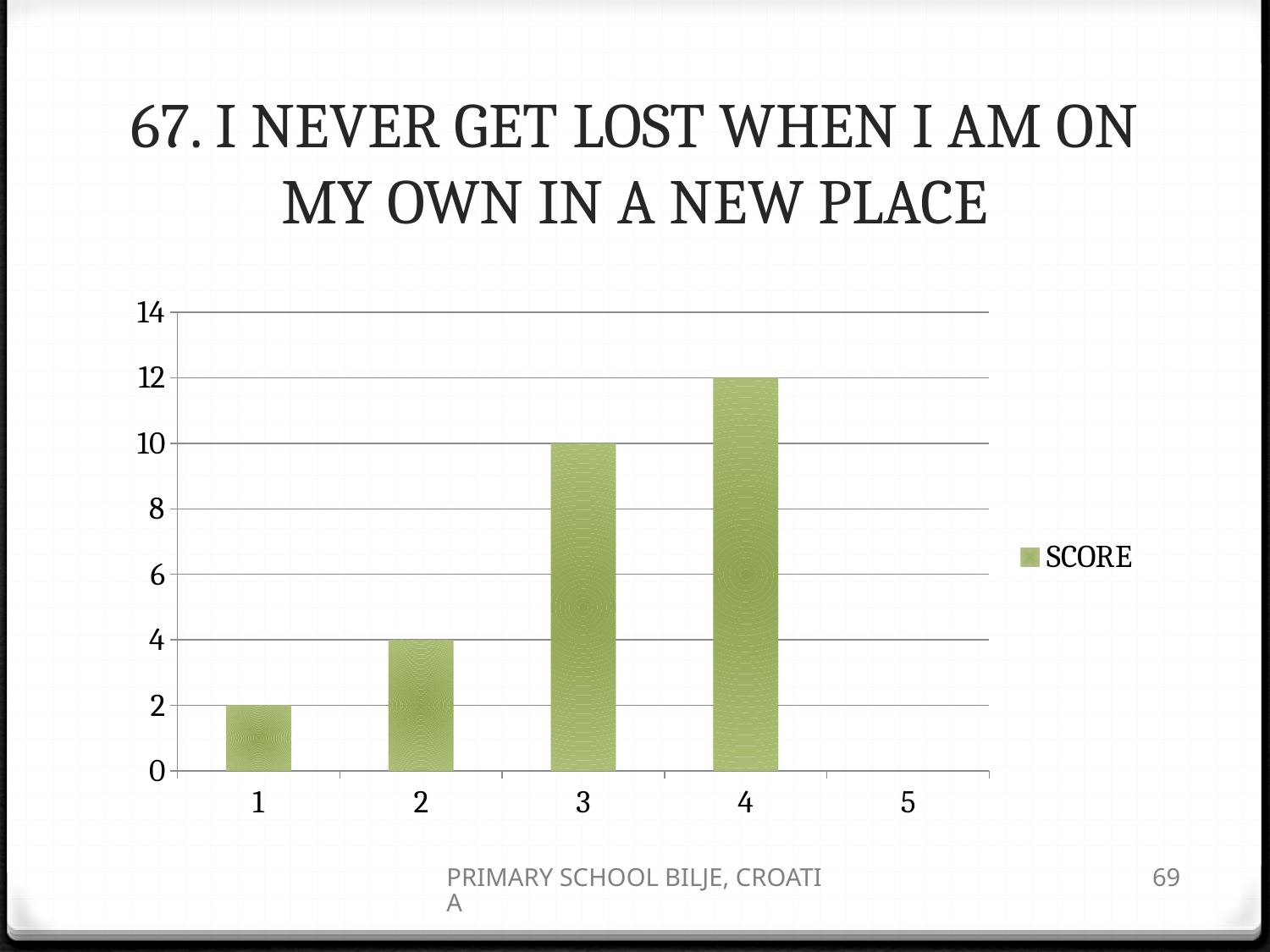
What is the SCORE value for category 4? 12 Which category has the lowest SCORE? 5 Which has a larger SCORE, category 2 or category 3? 3 What is the SCORE value for category 2? 4 How many categories are shown on the x axis? 5 What is the SCORE value for category 3? 10 What is the difference between the SCORE for category 4 and category 3? 2 What type of chart is shown on the slide? bar chart What is the SCORE value for category 1? 2 Which category has the highest SCORE? 4 What is the name of the series shown in the legend? SCORE How many series does the legend list? 1